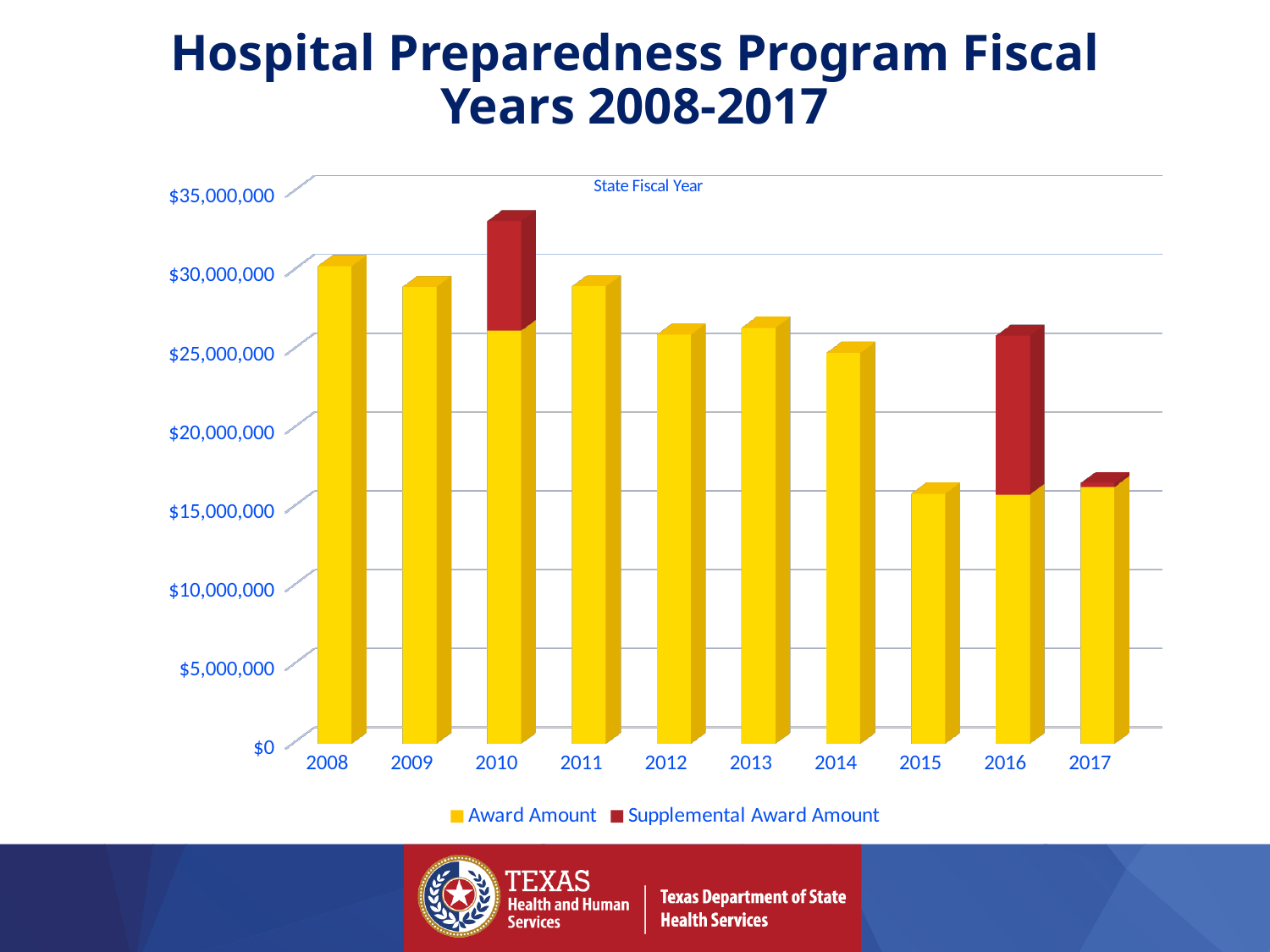
Overall, do the Award Amounts rise or fall from 2008 to 2017? fall How many series does the chart's legend list? 2 Which fiscal year has the highest Award Amount (yellow portion only)? 2008 Is the Award Amount for 2009 greater or less than $25,000,000? greater What kind of chart is shown on the slide? Bar chart Is the total bar for 2010 greater or less than $30,000,000? greater Which fiscal year has the tallest total bar (award plus supplemental)? 2010 Is the Award Amount for 2011 greater or less than $30,000,000? less Which is larger, the Supplemental Award Amount for 2016 or for 2010? 2016 How many fiscal years are shown on the x axis of the chart? 10 Which is larger, the Award Amount for 2008 or the Award Amount for 2015? 2008